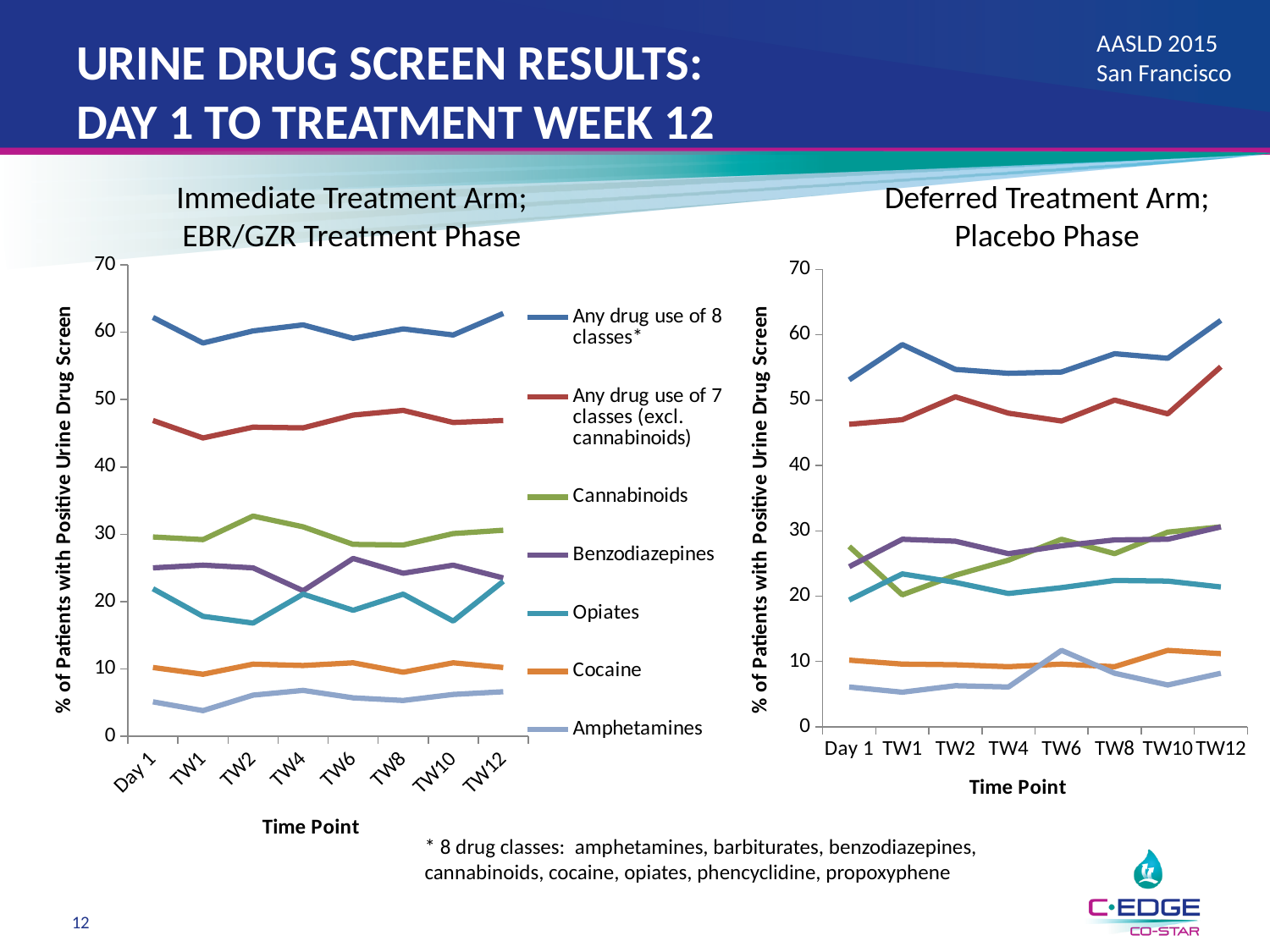
In the Immediate Treatment Arm chart, is the value for Any drug use of 8 classes at Day 1 greater or less than 60? greater How many series does the legend of the Immediate Treatment Arm chart list? 7 What kind of chart is the Immediate Treatment Arm chart on the left? line chart In the Deferred Treatment Arm chart, does the Any drug use of 8 classes line rise or fall from TW10 to TW12? rise In the Immediate Treatment Arm chart, which series has the highest value at Day 1? Any drug use of 8 classes In the Immediate Treatment Arm chart, is the value for Opiates at TW2 greater or less than 20? less How many time points are plotted along the x axis of the Deferred Treatment Arm chart on the right? 8 In the Immediate Treatment Arm chart, which is larger at Day 1: Benzodiazepines or Opiates? Benzodiazepines In the Deferred Treatment Arm chart, is the value for Any drug use of 7 classes at TW1 greater or less than 50? less In the Deferred Treatment Arm chart, which series has the lowest value at Day 1? Amphetamines What is the title of the chart on the right of the slide? Deferred Treatment Arm; Placebo Phase